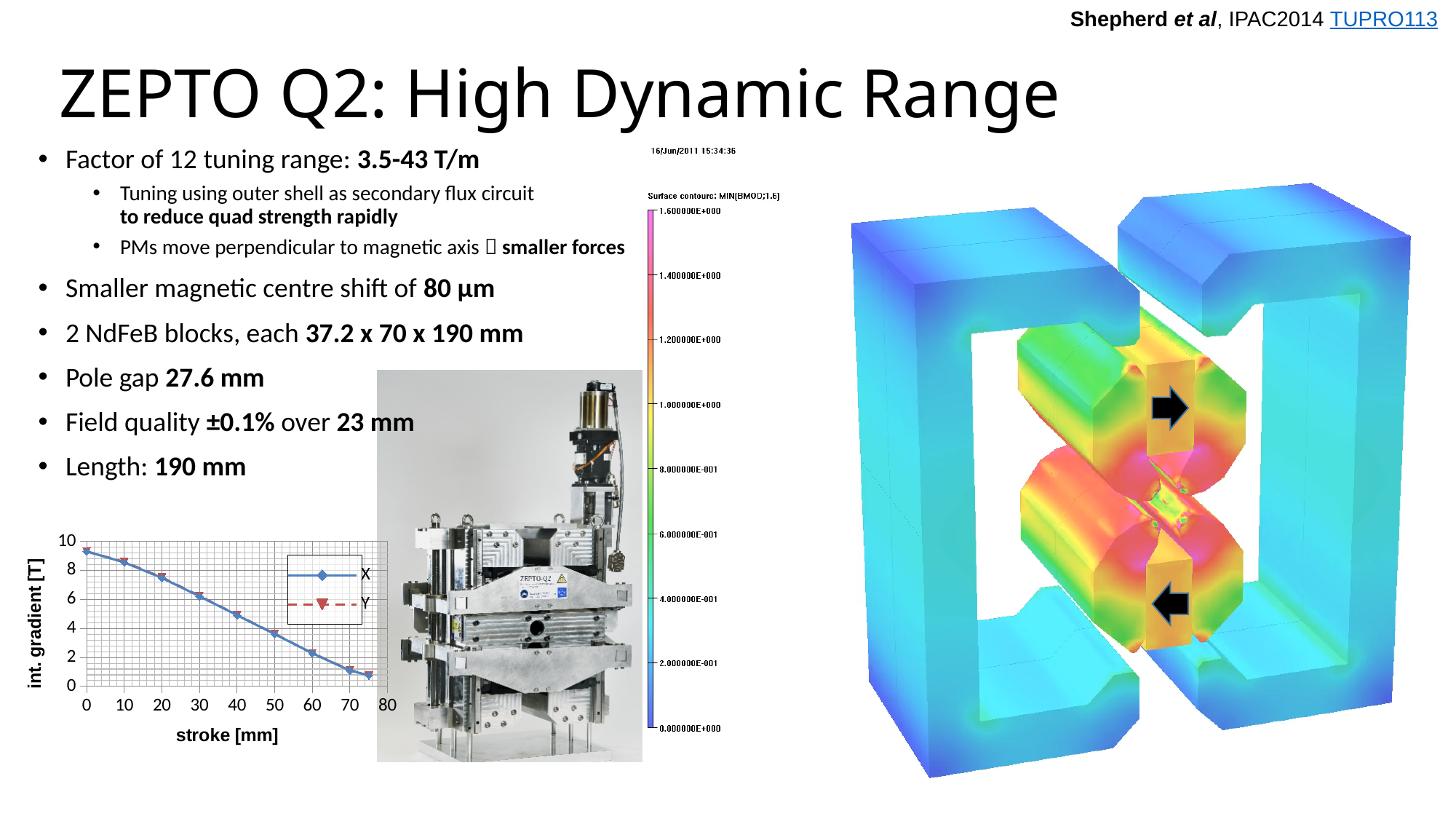
In the bottom-left chart, is the integrated gradient at a stroke of 40 mm greater or less than 6? less What are the two series named in the legend of the bottom-left chart? X and Y In the bottom-left chart, which is larger: the integrated gradient at a stroke of 10 mm or at 50 mm? 10 mm In the bottom-left chart, is the integrated gradient at a stroke of 70 mm greater or less than 2? less In the bottom-left chart, is the integrated gradient at a stroke of 60 mm greater or less than 4? less What kind of chart is shown at the bottom left of the slide? line chart In the bottom-left chart, at which stroke value is the integrated gradient highest? 0 How many series does the legend of the bottom-left chart list? 2 What is the x-axis label of the bottom-left chart? stroke [mm] In the bottom-left chart, does the integrated gradient rise or fall as the stroke increases? fall